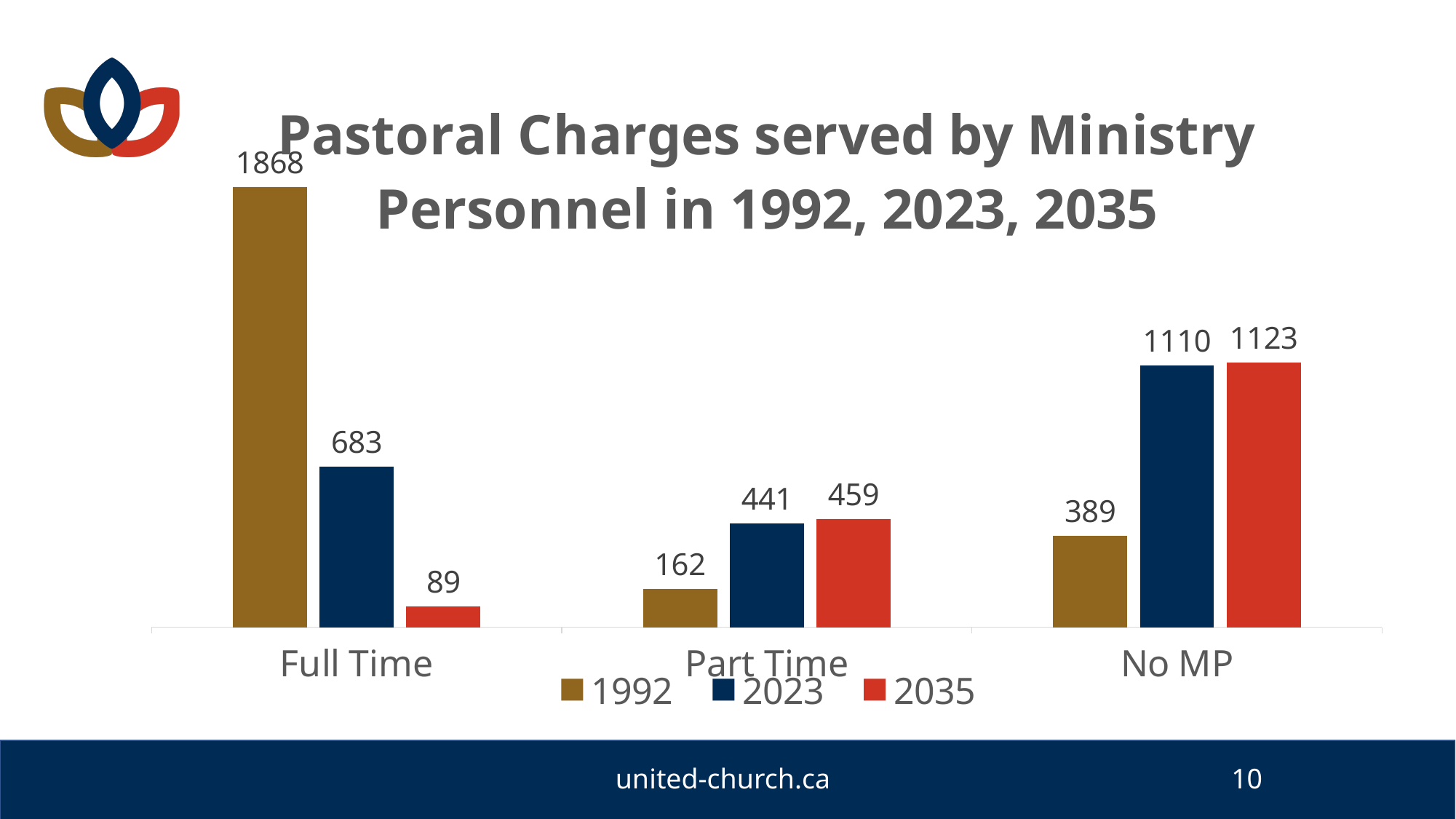
What is the value for Full Time in 1992? 1868 Which category has the lowest value for 1992? Part Time How many categories are shown on the x axis? 3 Which is larger, the Part Time value for 2035 or the No MP value for 1992? Part Time 2035 What is the difference between the No MP values for 2023 and 1992? 721 What kind of chart is shown on the slide? Bar chart What is the difference between the Full Time values for 1992 and 2023? 1185 What is the value for No MP in 2035? 1123 What is the title of the chart? Pastoral Charges served by Ministry Personnel in 1992, 2023, 2035 What is the value for Part Time in 2023? 441 Which category has the highest value for 2035? No MP How many series does the legend list? 3